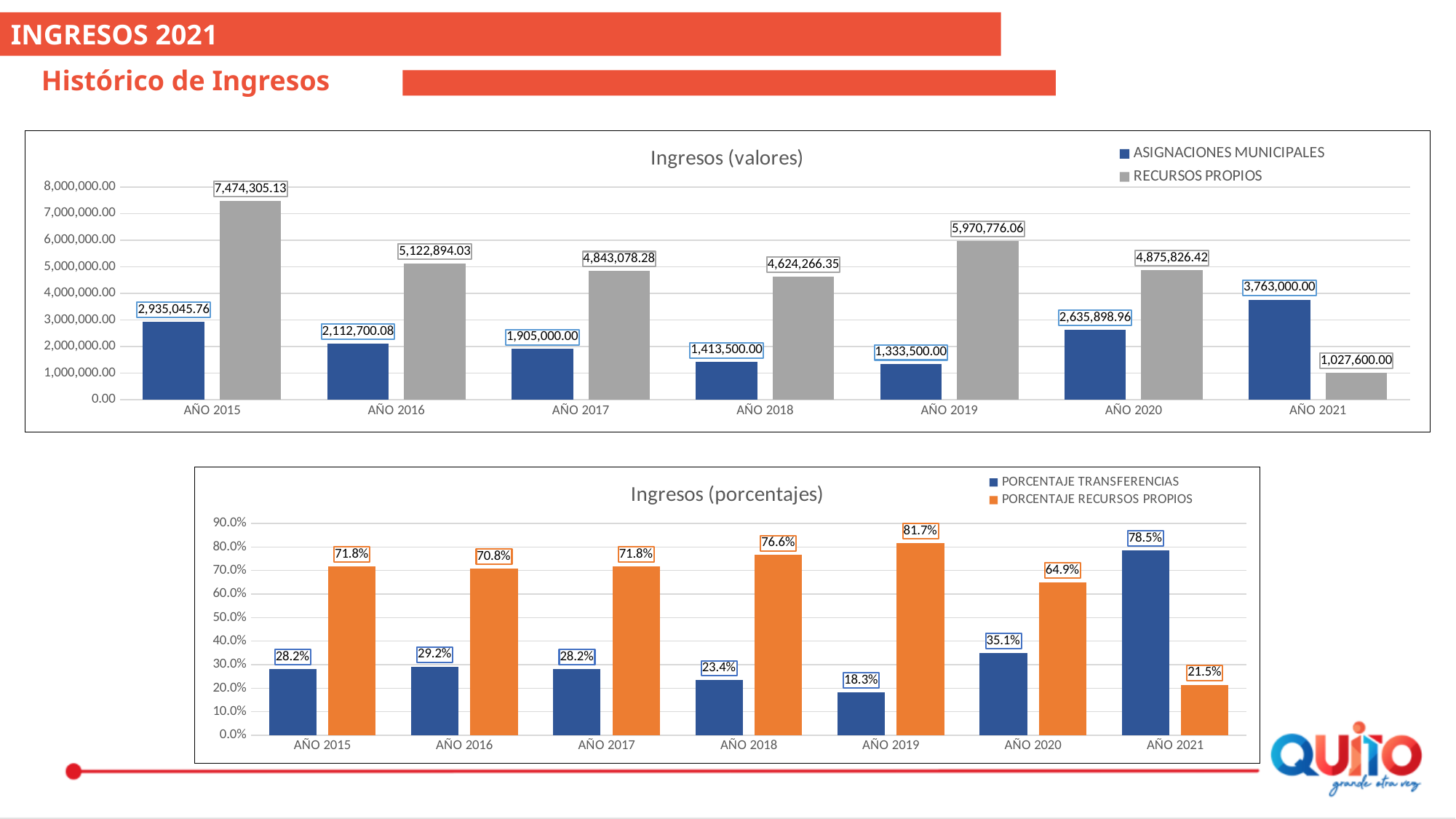
In the 'Ingresos (valores)' chart, which year has the highest RECURSOS PROPIOS value? AÑO 2015 How many series does the legend of the 'Ingresos (porcentajes)' chart list? 2 In the 'Ingresos (porcentajes)' chart, which year has the highest PORCENTAJE TRANSFERENCIAS? AÑO 2021 In the 'Ingresos (porcentajes)' chart, what is the PORCENTAJE RECURSOS PROPIOS for AÑO 2019? 81.7% In the 'Ingresos (valores)' chart, which year has the lowest ASIGNACIONES MUNICIPALES value? AÑO 2019 In the 'Ingresos (porcentajes)' chart, what is the PORCENTAJE TRANSFERENCIAS for AÑO 2018? 23.4% In the 'Ingresos (valores)' chart, which is larger for AÑO 2020: ASIGNACIONES MUNICIPALES or RECURSOS PROPIOS? RECURSOS PROPIOS What type of chart is the 'Ingresos (porcentajes)' chart? Bar chart In the 'Ingresos (valores)' chart, what is the value of ASIGNACIONES MUNICIPALES for AÑO 2021? 3,763,000.00 How many years are shown on the x axis of the 'Ingresos (valores)' chart? 7 In the 'Ingresos (valores)' chart, what is the difference between ASIGNACIONES MUNICIPALES and RECURSOS PROPIOS for AÑO 2021? 2,735,400.00 In the 'Ingresos (valores)' chart, what is the value of RECURSOS PROPIOS for AÑO 2015? 7,474,305.13